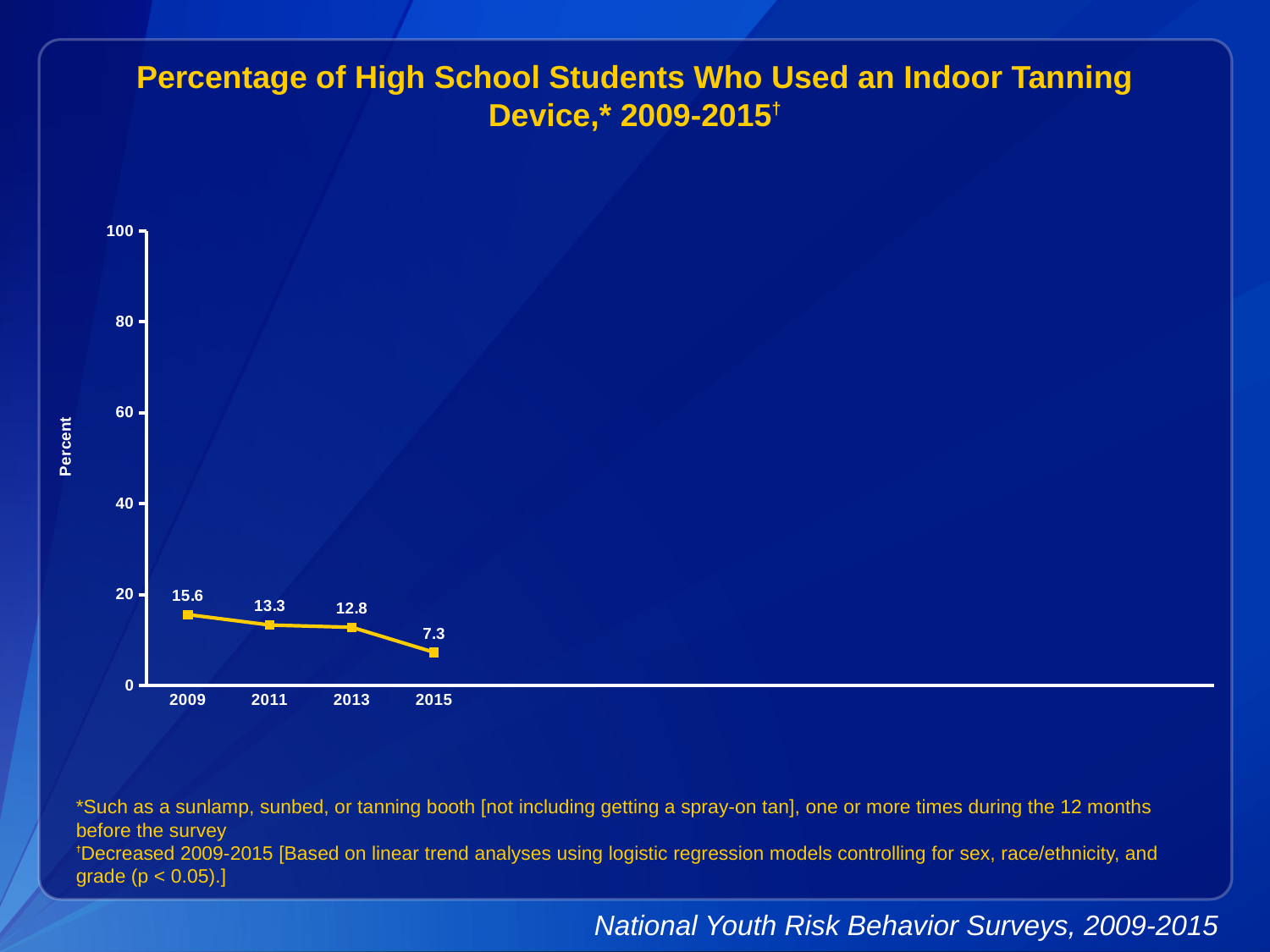
What percentage of high school students used an indoor tanning device in 2009? 15.6 What is the difference between the 2009 value and the 2015 value? 8.3 Is the value for 2009 greater or less than 20? less Which year has the larger value, 2013 or 2015? 2013 Which year has the highest value on the chart? 2009 What is the difference between the 2011 value and the 2013 value? 0.5 What is the value plotted for 2015? 7.3 What kind of chart is shown on the slide? line chart Which year has the lowest value on the chart? 2015 Do the values rise or fall from 2009 to 2015? fall What is the value plotted for 2011? 13.3 How many years are plotted on the chart? 4